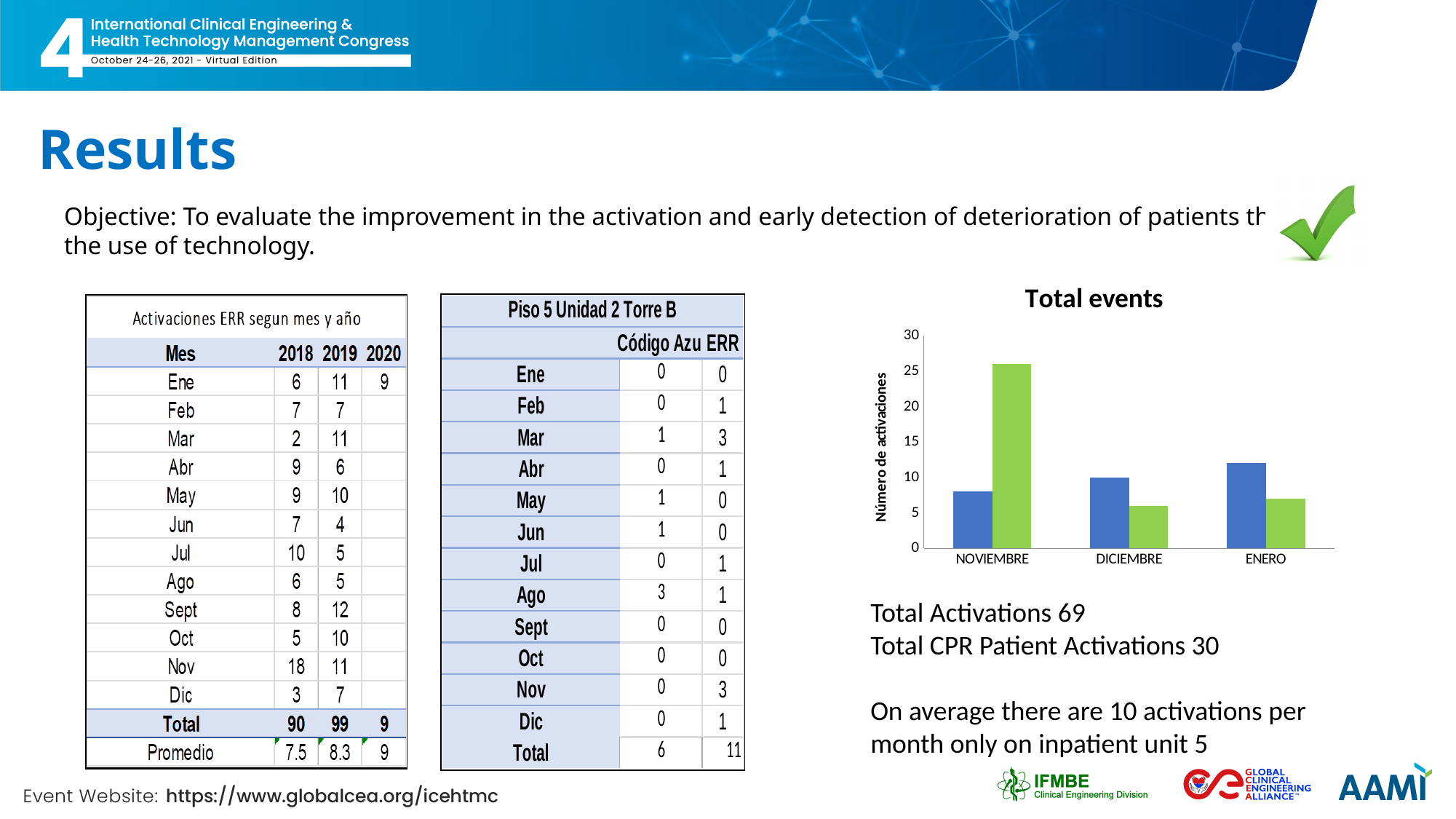
What is the label on the vertical axis of the "Total events" chart? Número de activaciones In the "Total events" chart, do the blue bars rise or fall from NOVIEMBRE to ENERO? rise In the "Total events" chart, which is larger: the green bar for NOVIEMBRE or the green bar for DICIEMBRE? NOVIEMBRE What is the title of the bar chart on the slide? Total events In the "Total events" chart, is the green bar for NOVIEMBRE greater or less than 20? greater In the "Total events" chart, is the blue bar for NOVIEMBRE greater or less than 10? less What kind of chart is the "Total events" chart? bar chart In the "Total events" chart, which category has the tallest bar? NOVIEMBRE In the "Total events" chart, which is larger: the blue bar for ENERO or the blue bar for NOVIEMBRE? ENERO In the "Total events" chart, is the green bar for ENERO greater or less than 10? less How many categories are shown on the x axis of the "Total events" chart? 3